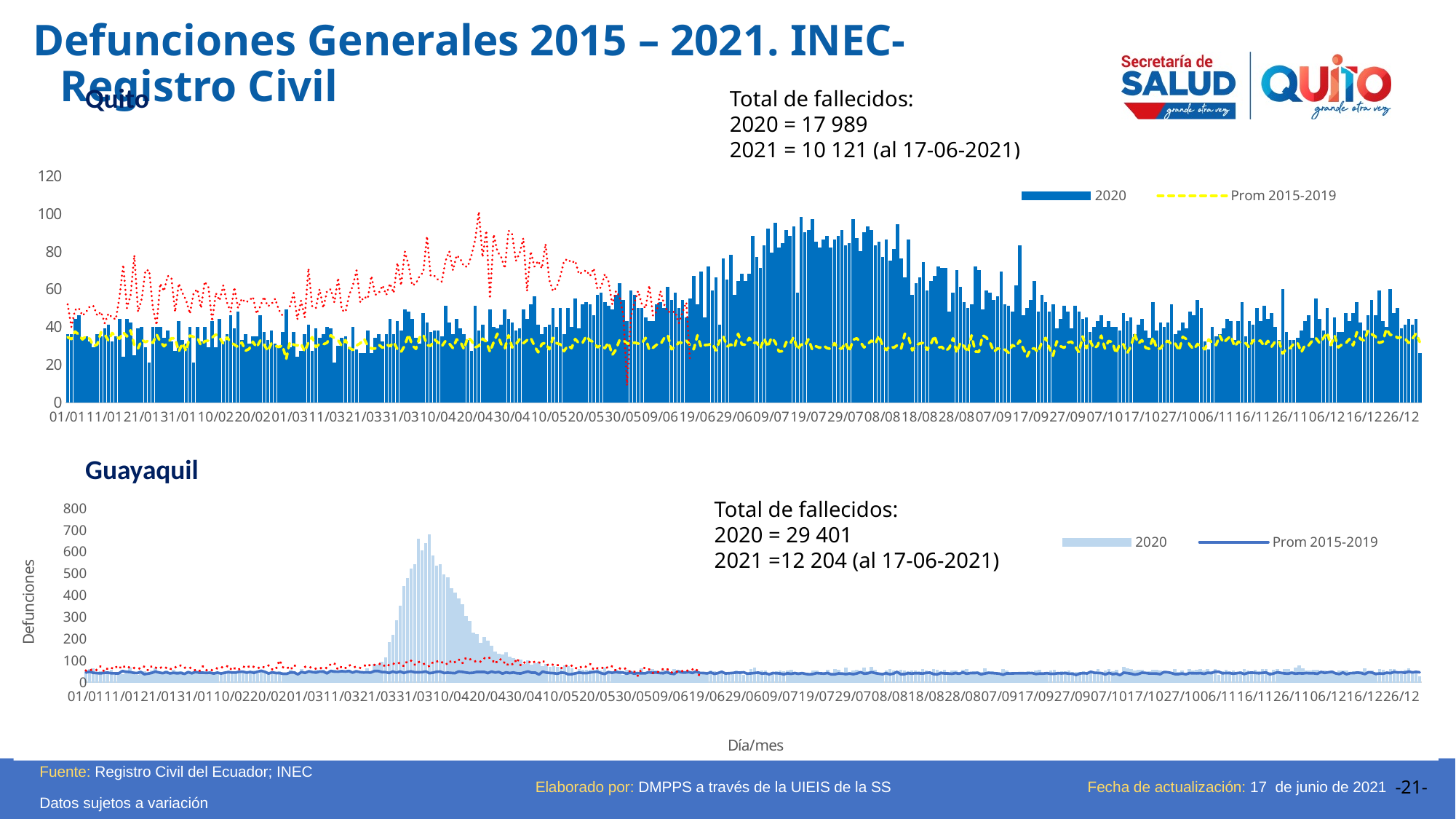
What is the x-axis title shown below the Guayaquil chart? Día/mes What kind of chart is the Quito chart? combination bar and line chart In the Quito chart, what is the total number of deaths stated for 2020? 17 989 Which city has the larger stated total of deaths for 2020, Quito or Guayaquil? Guayaquil In the Quito chart, is the highest 2020 daily bar greater or less than 80? greater In the Quito chart, what is the difference between the stated 2020 total and the stated 2021 total of deaths? 7 868 In the Guayaquil chart, what is the total number of deaths stated for 2020? 29 401 In the Guayaquil chart, what is the difference between the stated 2020 total and the stated 2021 total of deaths? 17 197 In the Quito chart, what is the total number of deaths stated for 2021 (al 17-06-2021)? 10 121 In the Guayaquil chart, is the highest 2020 daily bar greater or less than 600? greater In the Guayaquil chart, what is the total number of deaths stated for 2021 (al 17-06-2021)? 12 204 How many series does the legend of the Guayaquil chart list? 2